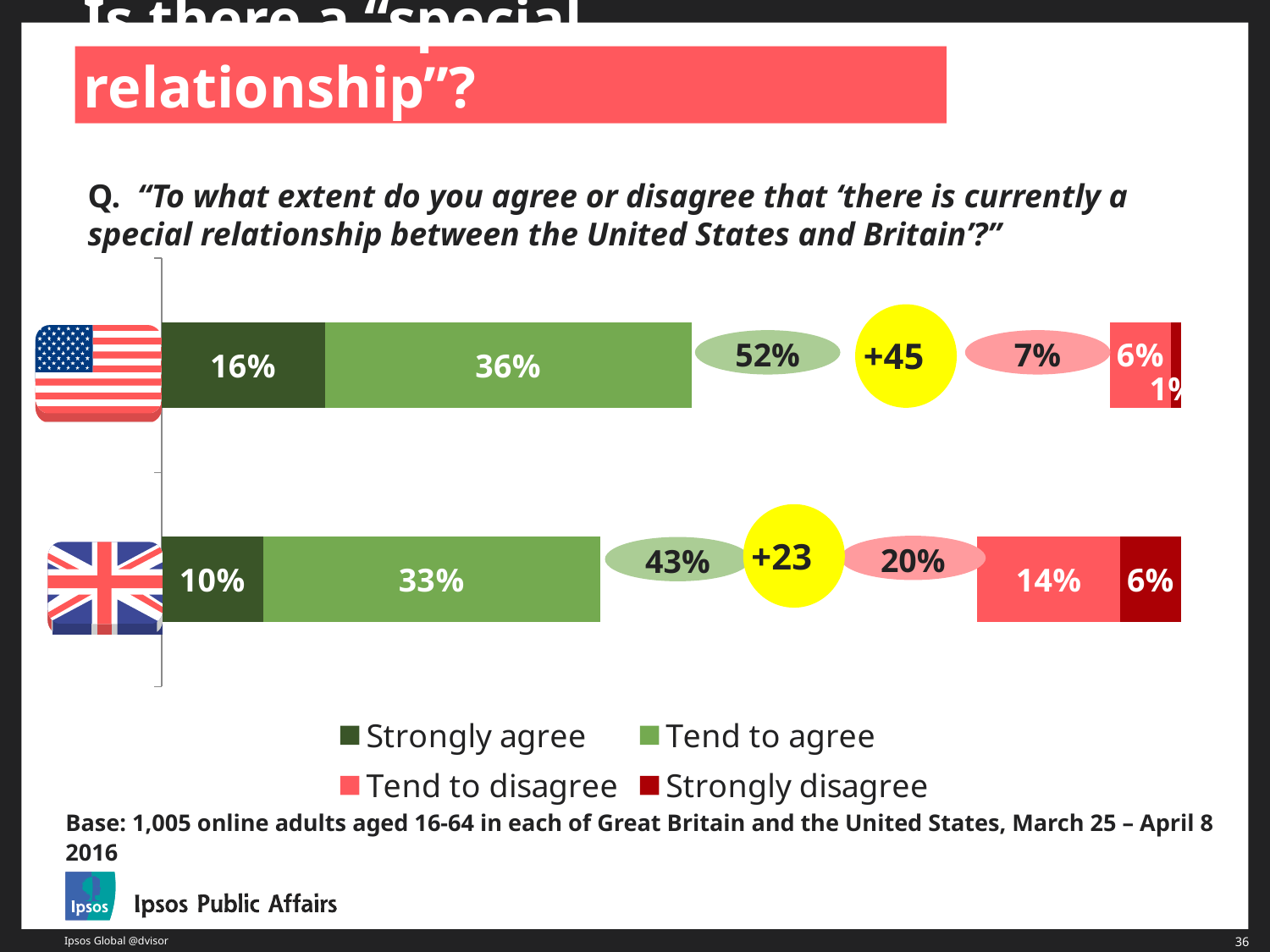
What net score is shown in the yellow circle for the row with the UK flag? +23 What is the 'Tend to disagree' value for the row with the UK flag? 14% What is the 'Tend to agree' value for the row with the US flag? 36% How many series does the legend list? 4 What is the 'Strongly agree' value for the row with the US flag? 16% What is the 'Strongly disagree' value for the row with the UK flag? 6% What is the combined agree total (Strongly agree plus Tend to agree) shown for the row with the US flag? 52% What is the 'Tend to agree' value for the row with the UK flag? 33% What kind of chart is shown on the slide? stacked bar chart What is the combined disagree total shown for the row with the UK flag? 20% Which row has the larger 'Strongly agree' value, the US flag row or the UK flag row? US flag row What is the difference between the 'Tend to disagree' values for the UK flag row and the US flag row? 8%